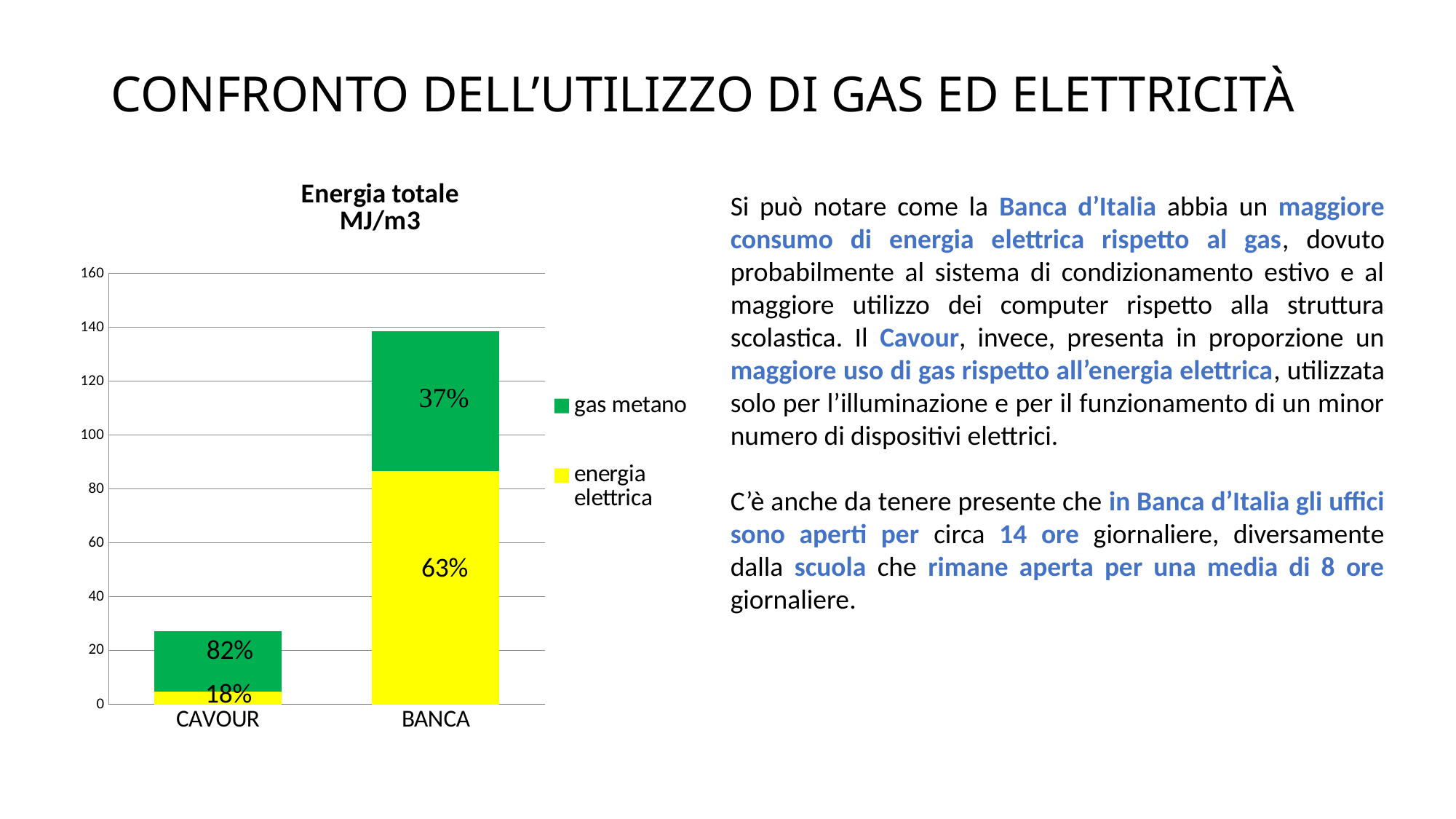
What percentage label is shown for gas metano in the CAVOUR bar? 82% How many series does the legend list? 2 What is the title of the chart? Energia totale MJ/m3 Which category has the taller total bar, CAVOUR or BANCA? BANCA How many categories are shown on the x axis? 2 What kind of chart is shown on the slide? stacked bar chart What percentage label is shown for energia elettrica in the CAVOUR bar? 18% What percentage label is shown for gas metano in the BANCA bar? 37% Which colour represents energia elettrica in the chart? yellow Is the total value of the CAVOUR bar greater or less than 40? less Is the total value of the BANCA bar greater or less than 120? greater What percentage label is shown for energia elettrica in the BANCA bar? 63%